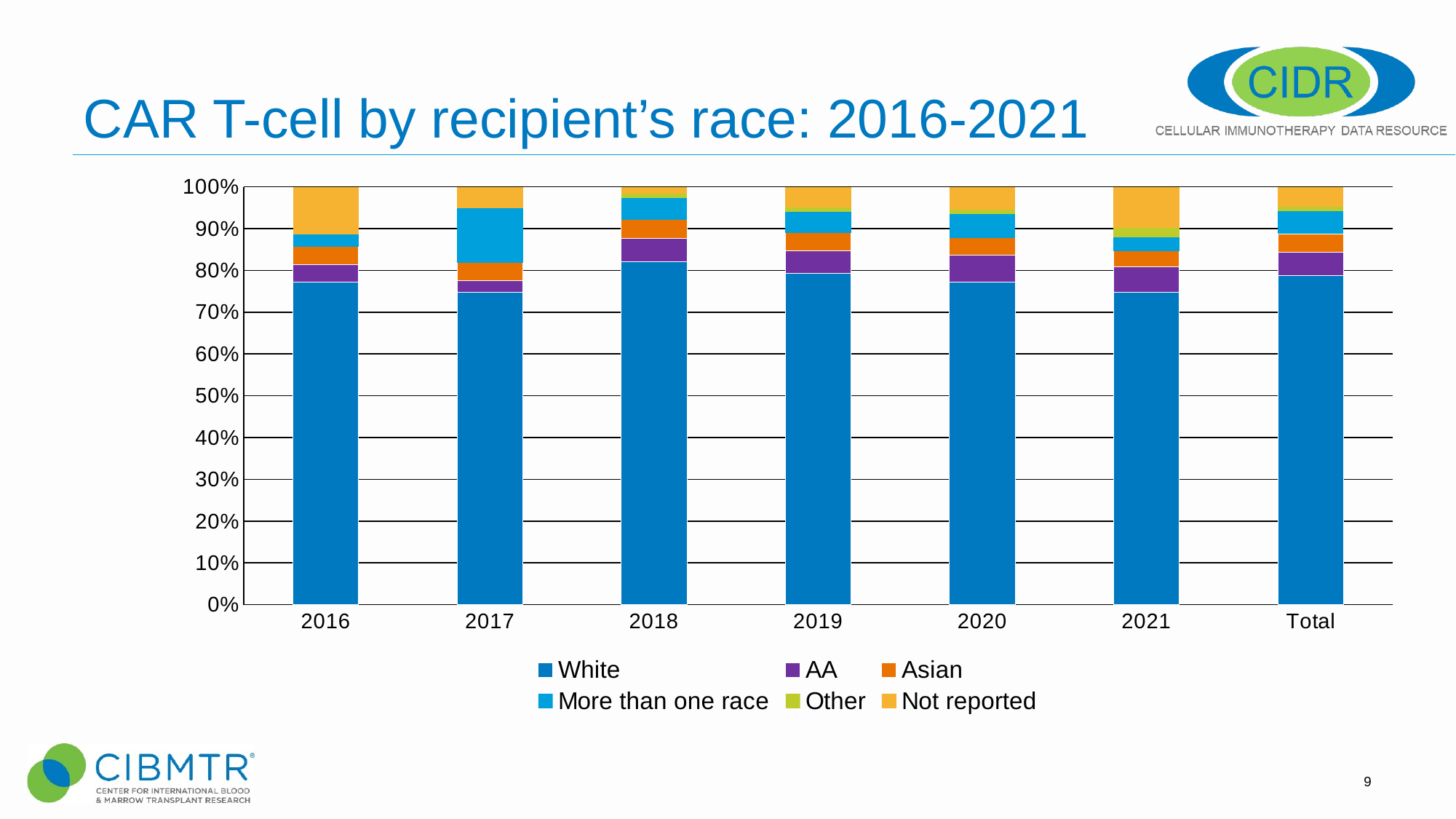
What is the total height of each stacked bar? 100% What is the title of the chart on the slide? CAR T-cell by recipient's race: 2016-2021 Is the White share for 2016 greater or less than 70%? greater In which year is the White share the largest? 2018 Is the White share for 2021 greater or less than 80%? less How many categories are shown along the x axis? 7 Which series is shown in dark blue in the legend? White Is the White share for 2018 greater or less than 80%? greater How many series does the legend list? 6 In which year is the More than one race share the largest? 2017 In which year is the Not reported share the largest? 2016 What kind of chart is shown on the slide? Stacked bar chart